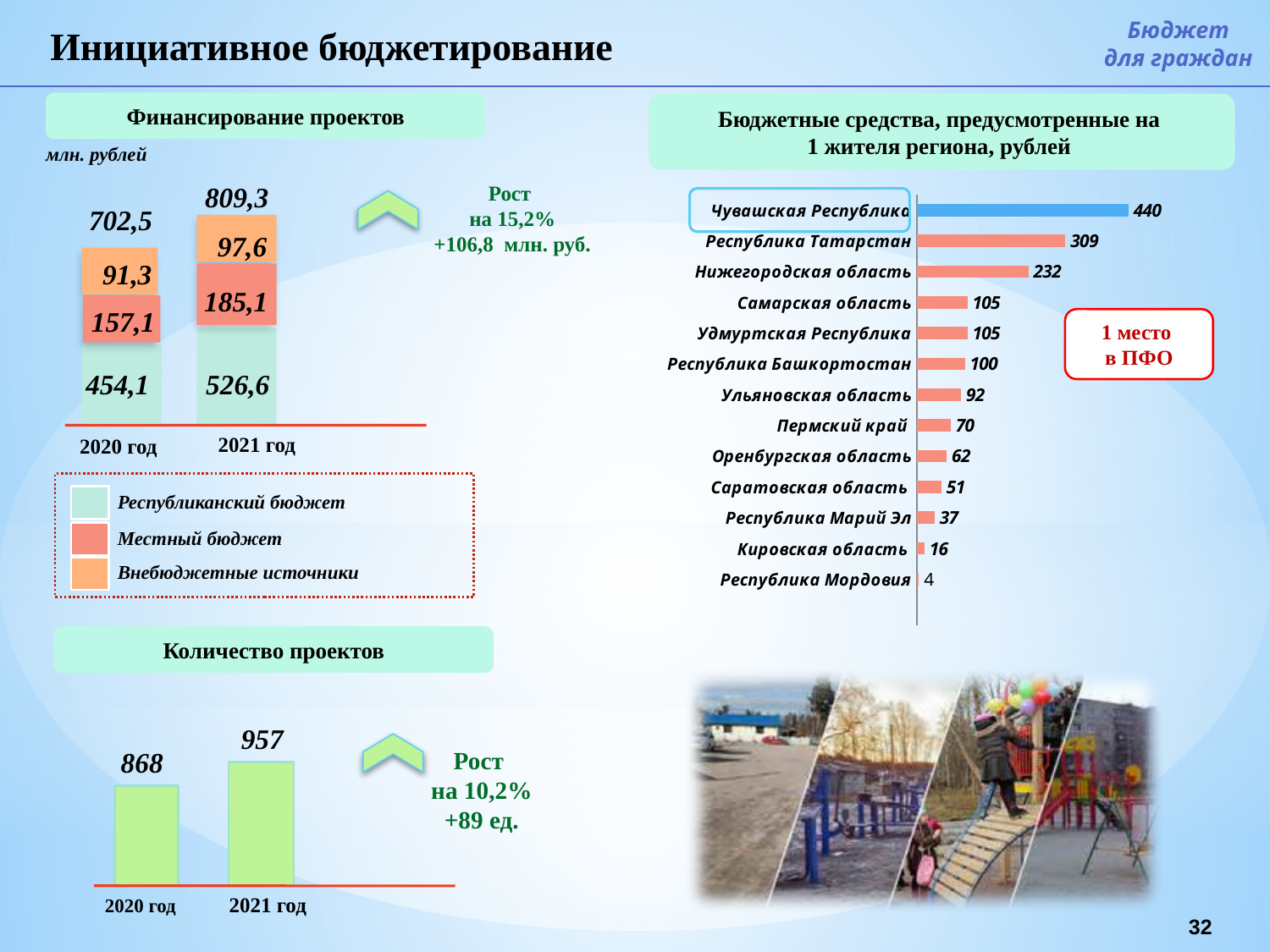
In the chart 'Бюджетные средства, предусмотренные на 1 жителя региона, рублей', which region has the lowest value? Республика Мордовия In the chart 'Бюджетные средства, предусмотренные на 1 жителя региона, рублей', what is the value for Чувашская Республика? 440 In the chart 'Финансирование проектов', how many series does the legend list? 3 What kind of chart is 'Бюджетные средства, предусмотренные на 1 жителя региона, рублей'? bar chart In the chart 'Бюджетные средства, предусмотренные на 1 жителя региона, рублей', which is larger: Пермский край or Оренбургская область? Пермский край In the chart 'Бюджетные средства, предусмотренные на 1 жителя региона, рублей', how many regions are shown? 13 In the chart 'Количество проектов', what is the difference between 2021 год and 2020 год? 89 In the chart 'Бюджетные средства, предусмотренные на 1 жителя региона, рублей', what is the difference between Республика Татарстан and Нижегородская область? 77 In the chart 'Финансирование проектов', what is the total of the stacked bar for 2020 год? 702,5 In the chart 'Финансирование проектов', what is the value of Республиканский бюджет for 2021 год? 526,6 In the chart 'Бюджетные средства, предусмотренные на 1 жителя региона, рублей', which region has the highest value? Чувашская Республика In the chart 'Количество проектов', do the values rise or fall from 2020 год to 2021 год? rise